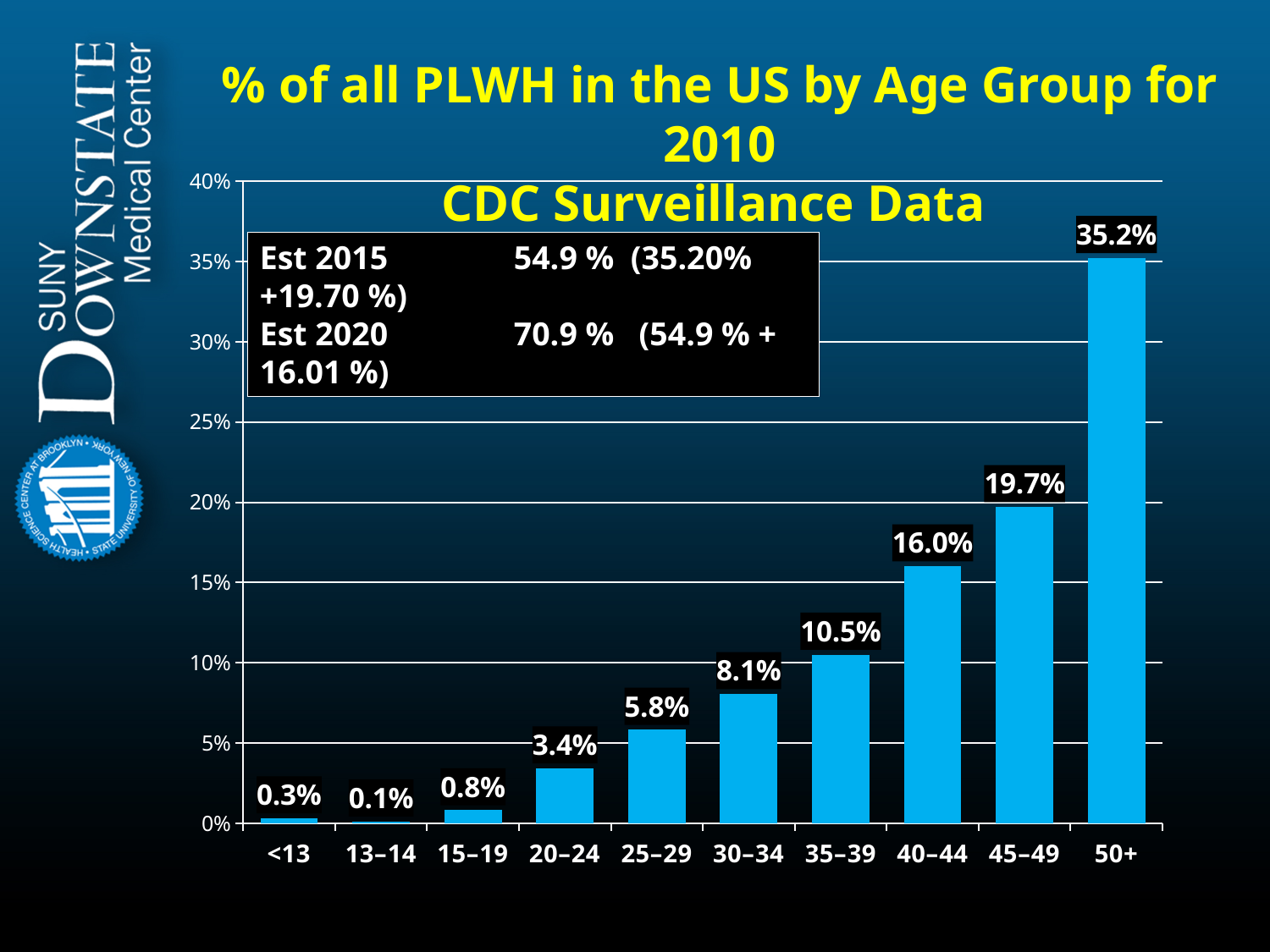
Do the values generally rise or fall from the 13–14 group to the 50+ group? rise Is the value for 45–49 greater or less than 20%? less How many age groups are shown on the x axis? 10 What is the title of the chart? % of all PLWH in the US by Age Group for 2010 CDC Surveillance Data What is the difference between the values for 50+ and 45–49? 15.5% What value is shown for the 40–44 age group? 16.0% What kind of chart is this? bar chart Which age group has the highest percentage? 50+ What percentage of all PLWH is shown for the 50+ age group? 35.2% Which age group has the lowest percentage? 13–14 Which is larger, the value for 35–39 or the value for 30–34? 35–39 What value is shown for the 25–29 age group? 5.8%